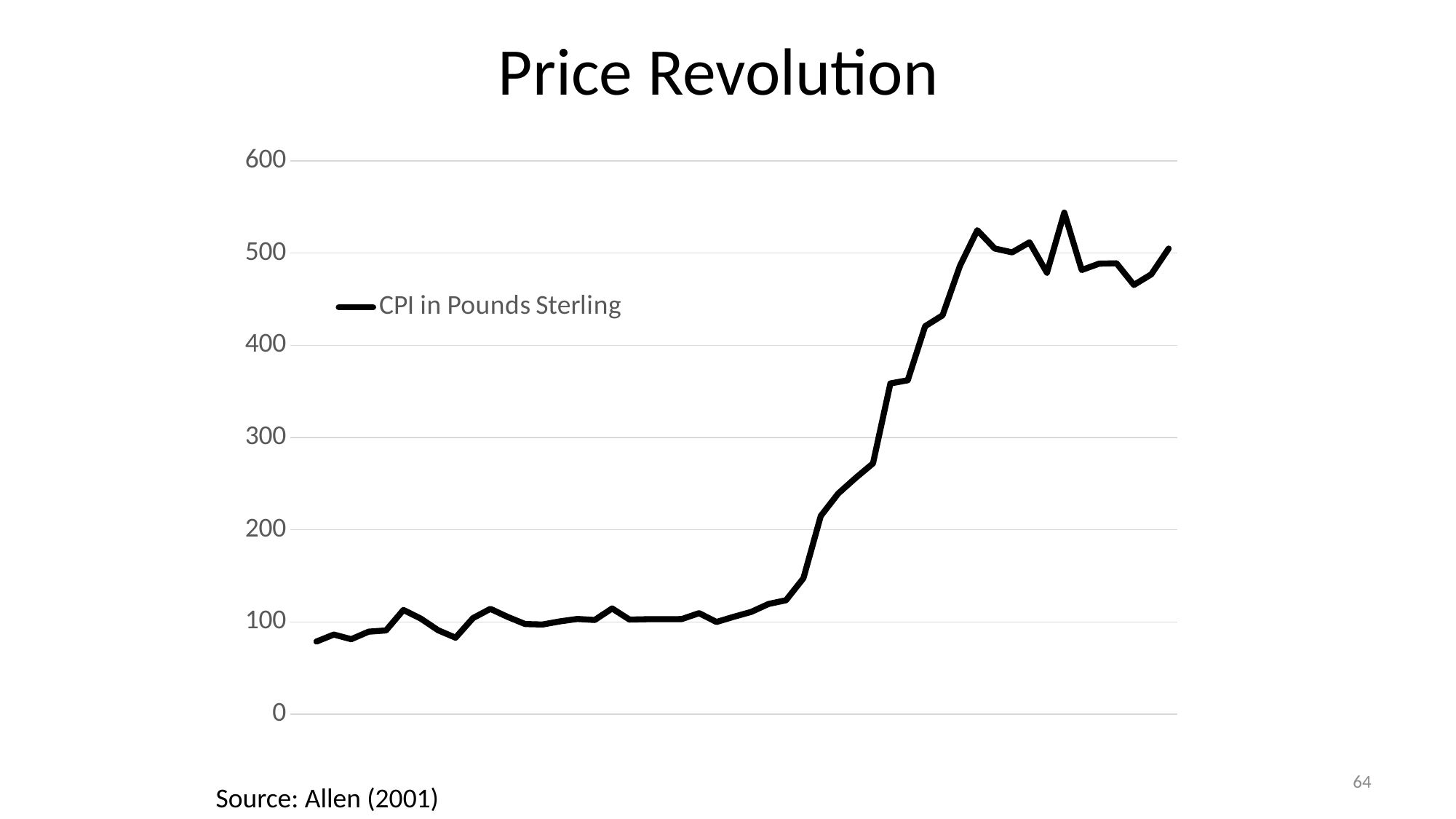
Overall, does the CPI in Pounds Sterling line rise or fall from left to right? rise Is the highest point of the CPI in Pounds Sterling line greater or less than 600? less Is the first (leftmost) value of the CPI in Pounds Sterling line greater or less than 100? less Is the highest point of the CPI in Pounds Sterling line greater or less than 500? greater What kind of chart is shown on the slide? line chart What series name does the legend show? CPI in Pounds Sterling Which is larger, the first value or the last value of the CPI in Pounds Sterling line? the last value How many series does the legend list? 1 What is the title of the chart? Price Revolution What is the highest tick value shown on the vertical axis? 600